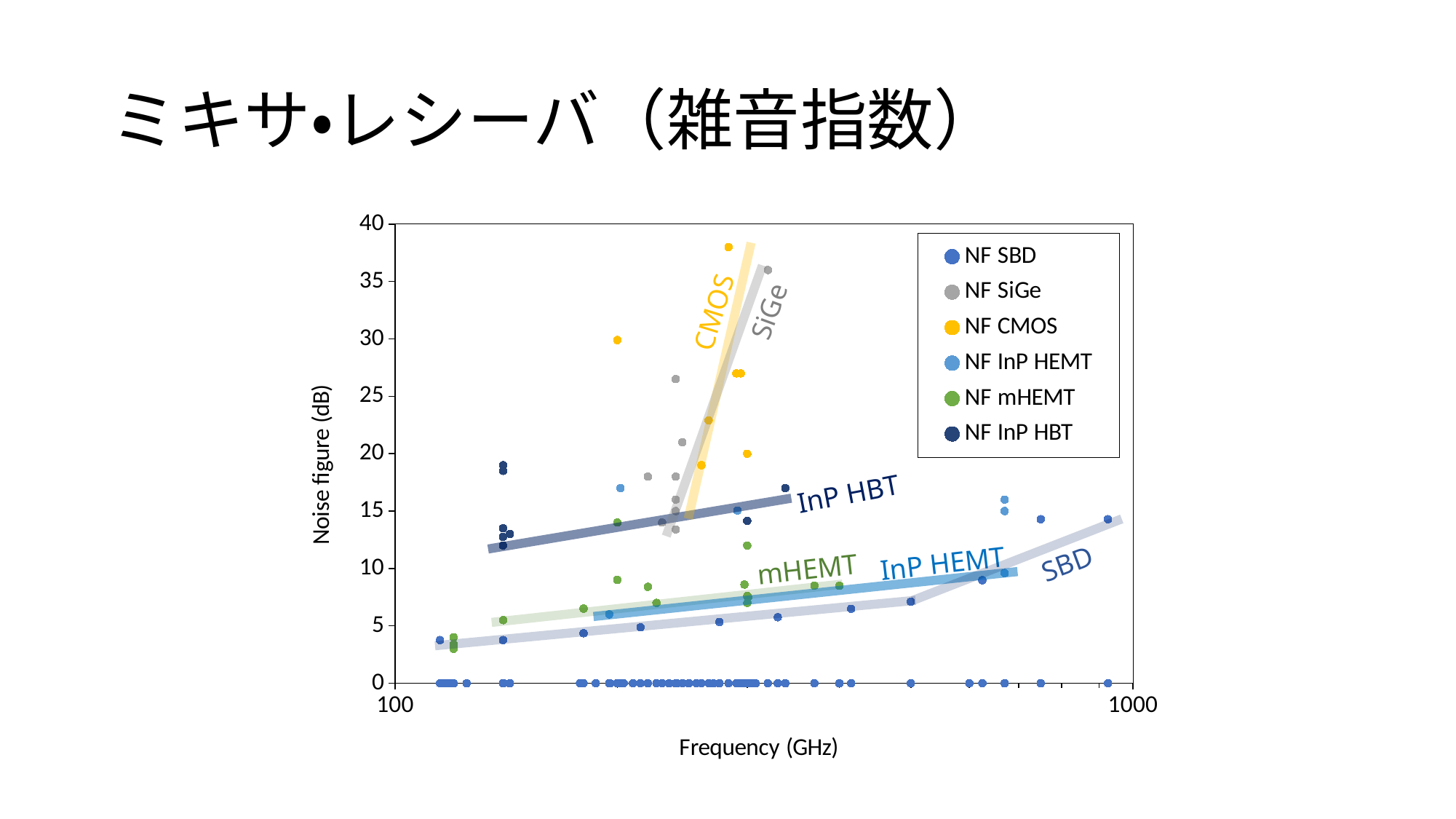
What kind of chart is shown on the slide? scatter chart Does the CMOS trend line rise or fall as frequency increases? rise Is the highest NF CMOS point greater or less than 35 dB? greater Is the highest NF InP HBT point near 150 GHz greater or less than 15 dB? greater Does the SBD trend line rise or fall as frequency increases? rise What is the label of the x axis? Frequency (GHz) Which series reaches the highest noise figure value on the chart? NF CMOS Is the lowest NF mHEMT point greater or less than 5 dB? less How many series does the legend list? 6 What is the label of the y axis? Noise figure (dB)